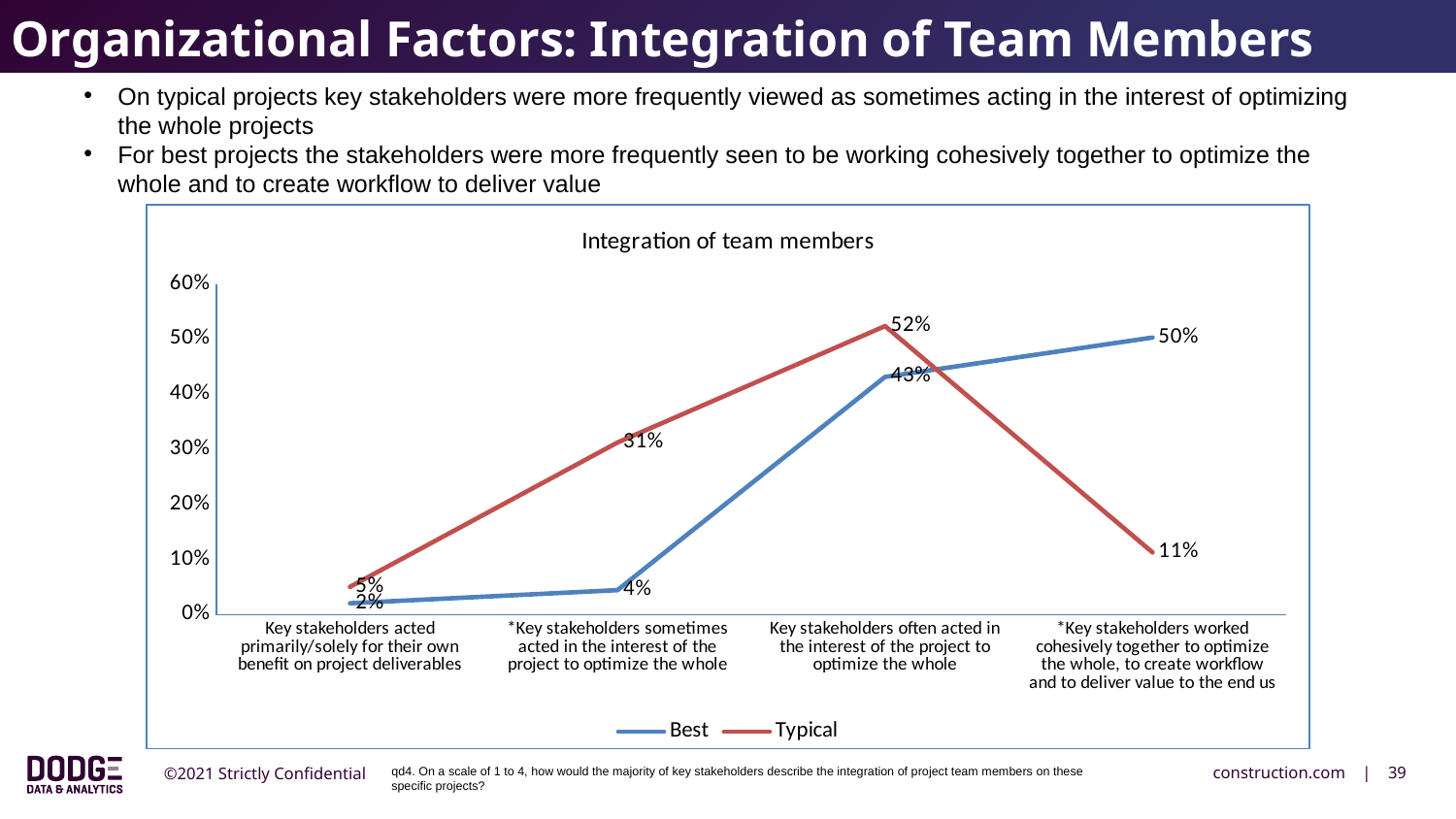
What is the Typical value for 'Key stakeholders often acted in the interest of the project to optimize the whole'? 52% What is the title of the chart? Integration of team members Does the Best series rise or fall from left to right across the categories? Rise What is the Typical value for '*Key stakeholders sometimes acted in the interest of the project to optimize the whole'? 31% Which category has the lowest Best value? Key stakeholders acted primarily/solely for their own benefit on project deliverables What is the difference between the Best and Typical values for 'Key stakeholders worked cohesively together to optimize the whole, to create workflow and to deliver value to the end us'? 39% Which category has the highest Typical value? Key stakeholders often acted in the interest of the project to optimize the whole What is the Best value for 'Key stakeholders worked cohesively together to optimize the whole, to create workflow and to deliver value to the end us'? 50% For 'Key stakeholders often acted in the interest of the project to optimize the whole', which series has the larger value, Best or Typical? Typical How many series does the legend list? 2 What type of chart is shown on the slide? Line chart How many categories are shown on the x axis? 4